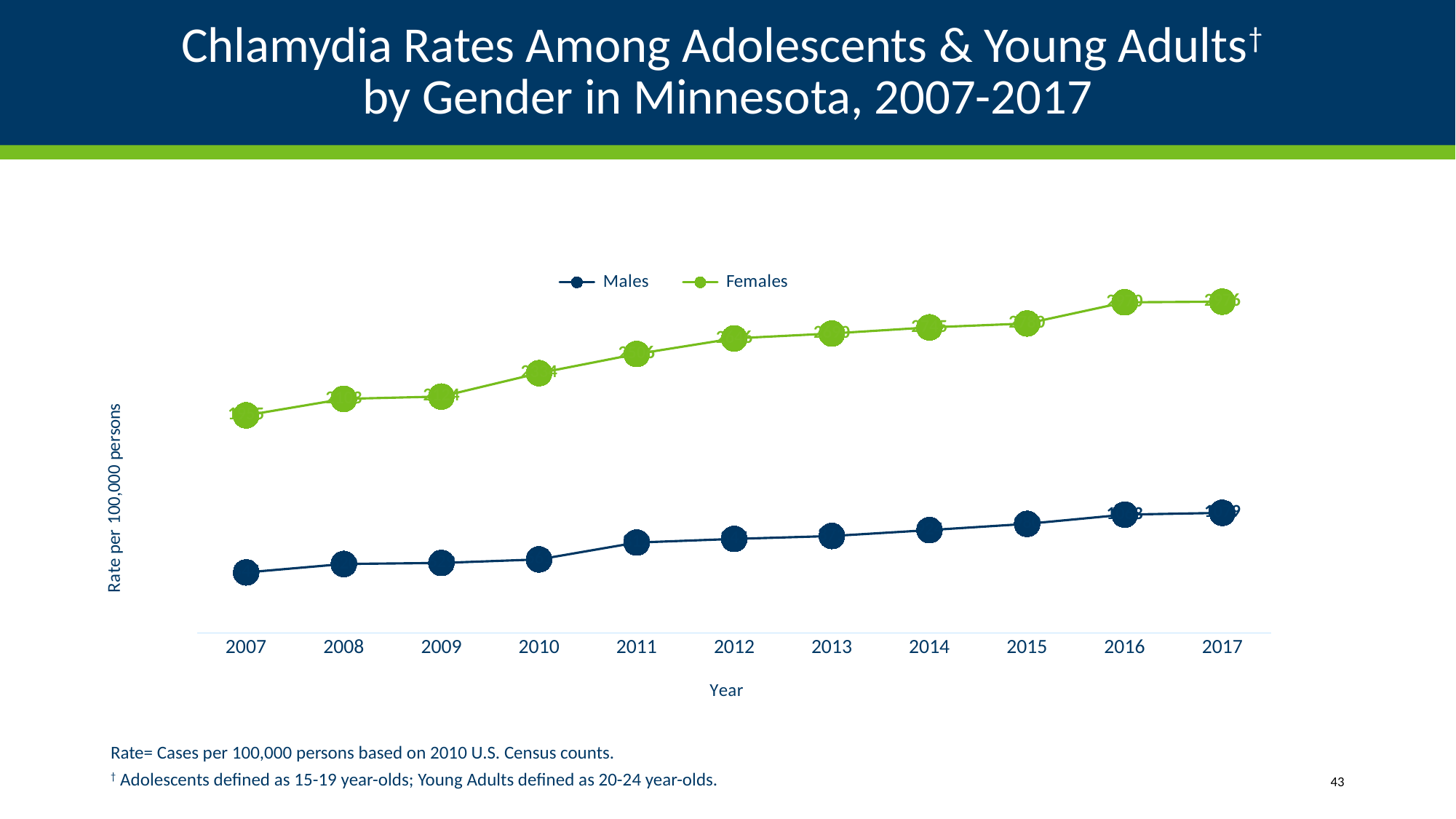
Which series has the higher rate in 2012, Males or Females? Females How many series does the legend list? 2 In which year is the Females rate lowest? 2007 In which year is the Males rate lowest? 2007 Do the Females rates generally rise or fall from 2007 to 2017? Rise What are the two series named in the legend? Males and Females What kind of chart is shown on the slide? Line chart What is the label on the y axis? Rate per 100,000 persons Do the Males rates generally rise or fall from 2007 to 2017? Rise Which series has the lower rate in 2017, Males or Females? Males How many years are plotted along the x axis? 11